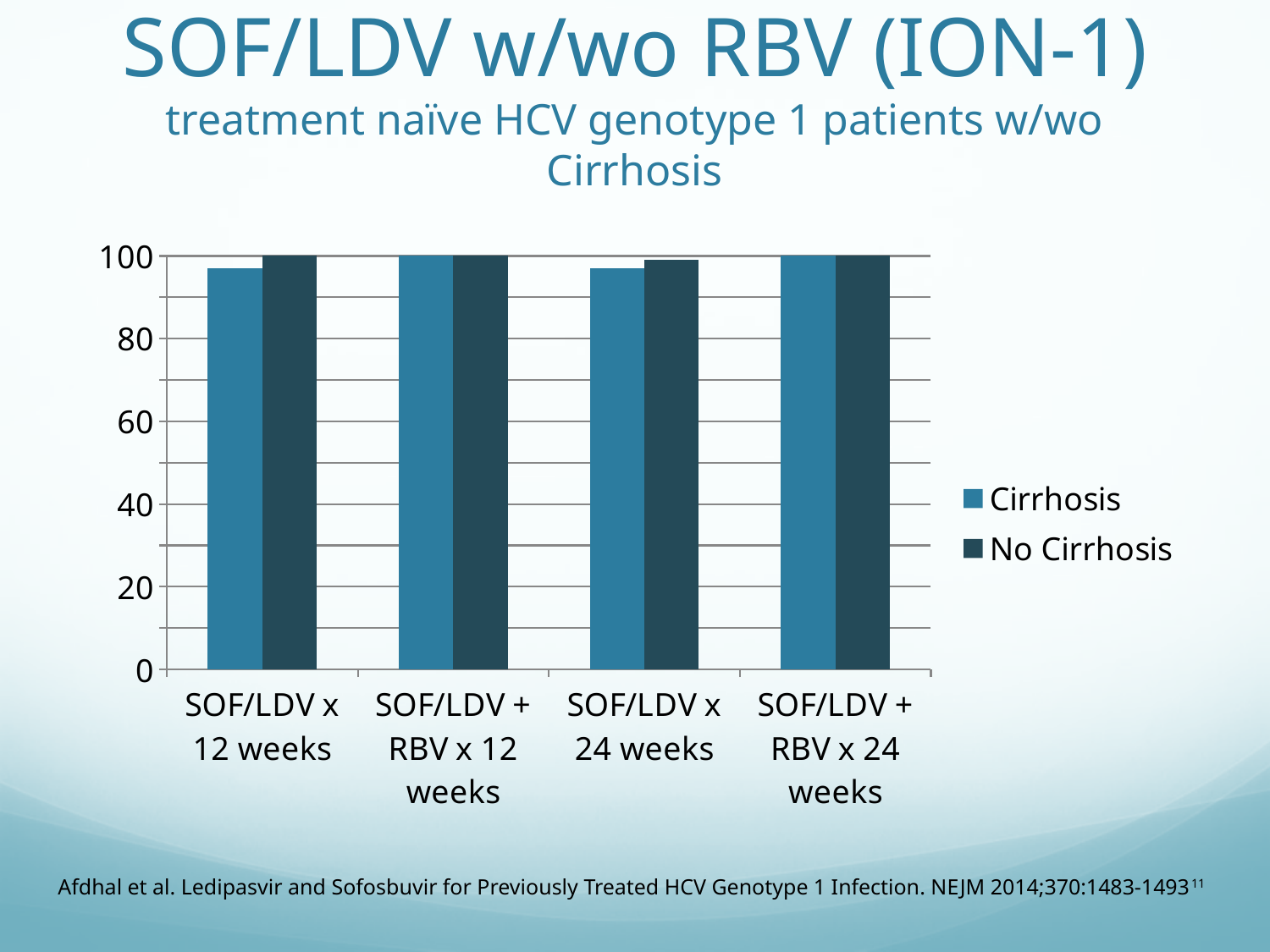
Is the Cirrhosis value for SOF/LDV x 12 weeks greater or less than 80? greater How many series does the legend list? 2 Which series is drawn in the darker bars? No Cirrhosis What kind of chart is shown on the slide? bar chart What is the highest value shown on the y axis? 100 What is the Cirrhosis value for SOF/LDV + RBV x 24 weeks? 100 How many treatment regimens (categories) are shown on the x axis? 4 For SOF/LDV x 12 weeks, which is larger: the Cirrhosis bar or the No Cirrhosis bar? No Cirrhosis Is the Cirrhosis value for SOF/LDV x 24 weeks greater or less than 80? greater Is the No Cirrhosis value for SOF/LDV x 24 weeks greater or less than 60? greater What is the No Cirrhosis value for SOF/LDV + RBV x 12 weeks? 100 What are the two series named in the legend? Cirrhosis and No Cirrhosis